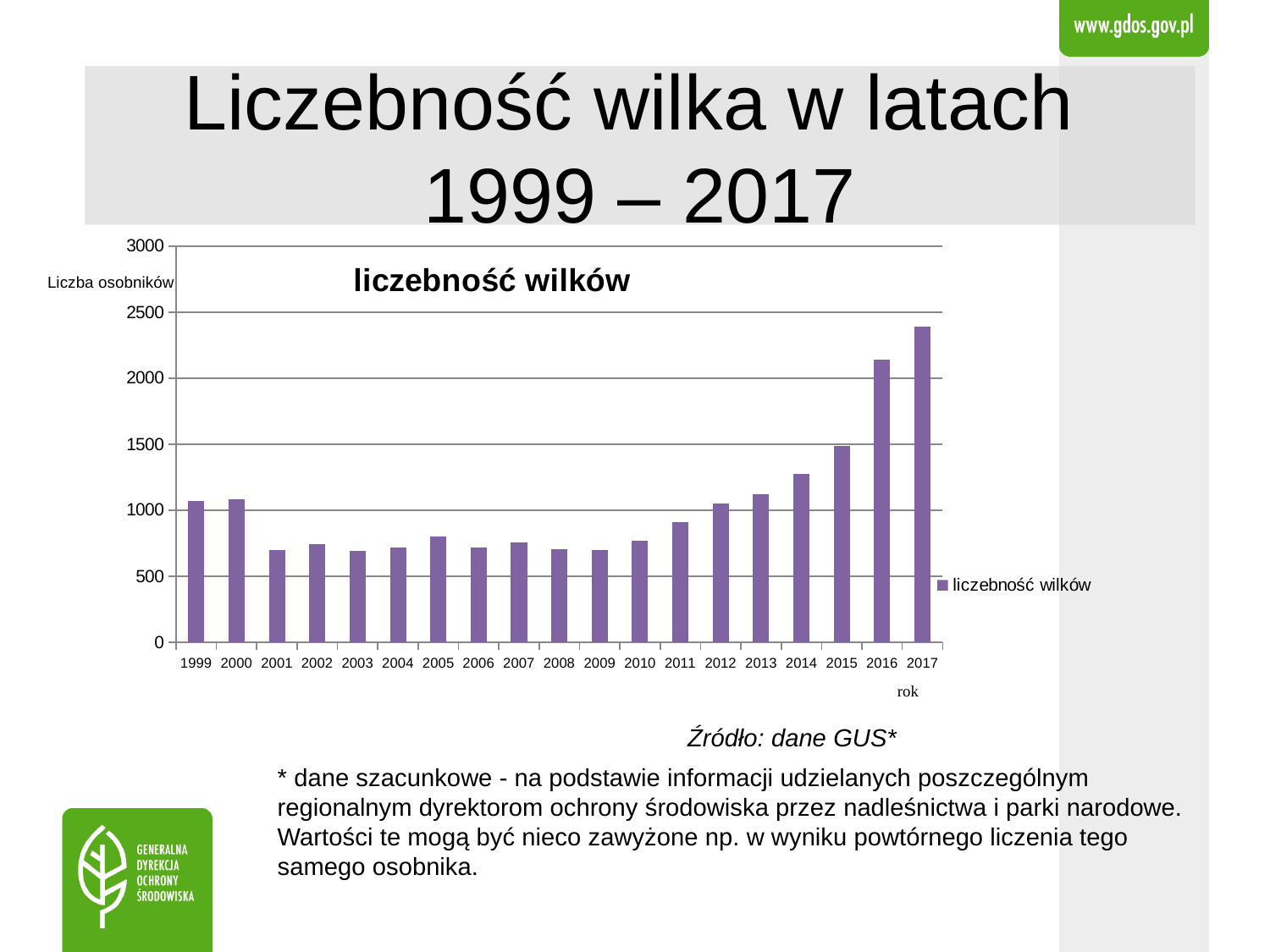
Is the value for 2011 greater or less than 1000? less Do the values rise or fall from 2011 to 2017? rise Is the value for 2014 greater or less than 1000? greater How many years (bars) are plotted in the chart? 19 Is the value for 2001 greater or less than 500? greater Which year has the highest wolf count in the chart? 2017 How many series does the legend list? 1 What label is shown on the x axis of the chart? rok What is the title shown inside the chart area? liczebność wilków Which year has the larger value, 2005 or 2016? 2016 What type of chart is shown on the slide? bar chart